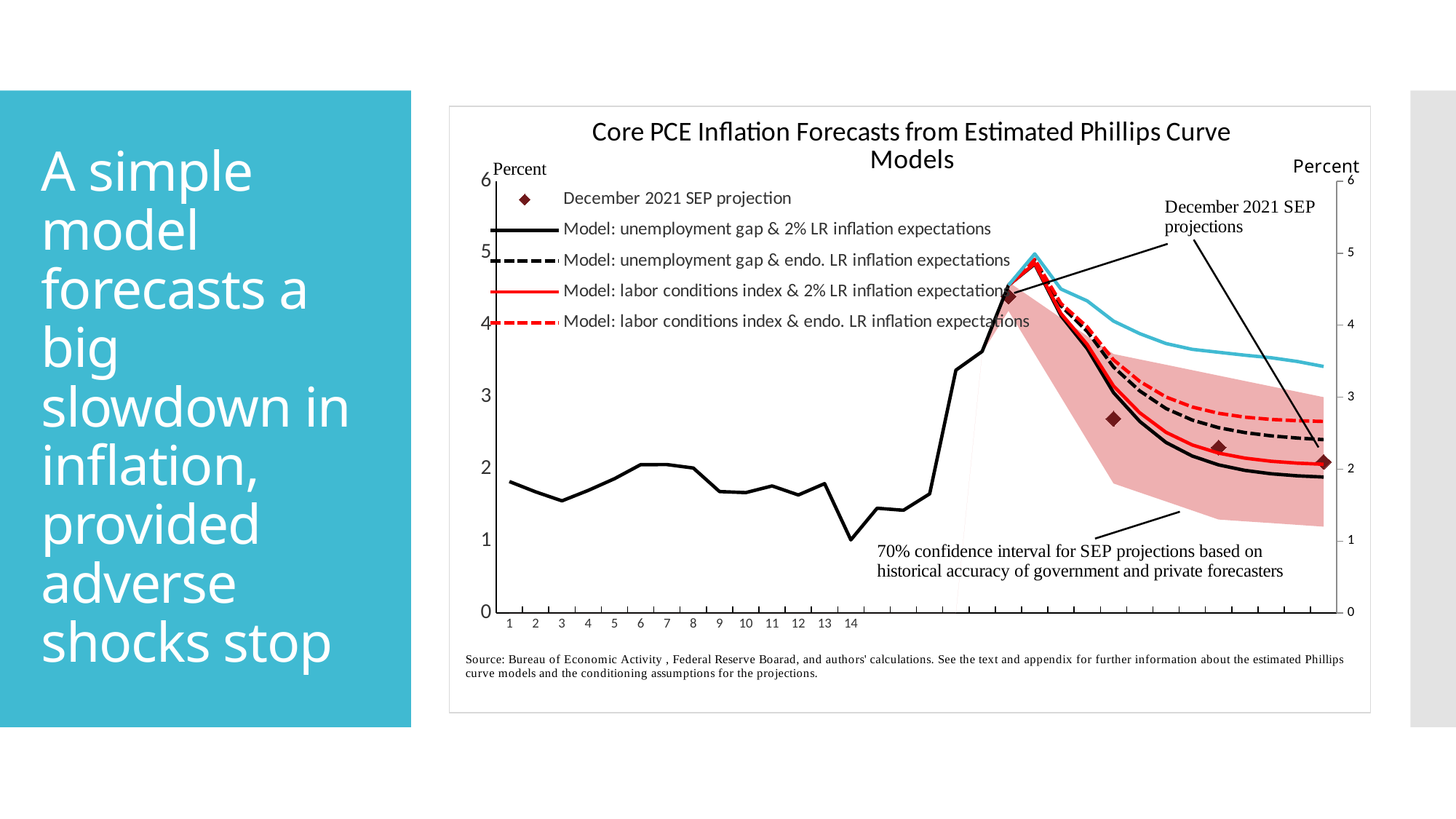
What unit is shown on the vertical axis of the chart? Percent Is the value of the solid black line at x-axis point 1 greater or less than 2? less Is the value of the solid black line at x-axis point 14 greater or less than 2? less Is the peak value of the solid black line greater or less than 4? greater At the right edge of the chart, which model line is lowest? Model: unemployment gap & 2% LR inflation expectations What kind of chart is shown on the slide? line chart After reaching its peak, do the model forecast lines rise or fall moving to the right along the x axis? fall At the right edge of the chart, which is higher: the dashed red line or the solid black line? dashed red line What is the title of the chart? Core PCE Inflation Forecasts from Estimated Phillips Curve Models How many entries does the chart's legend list? 5